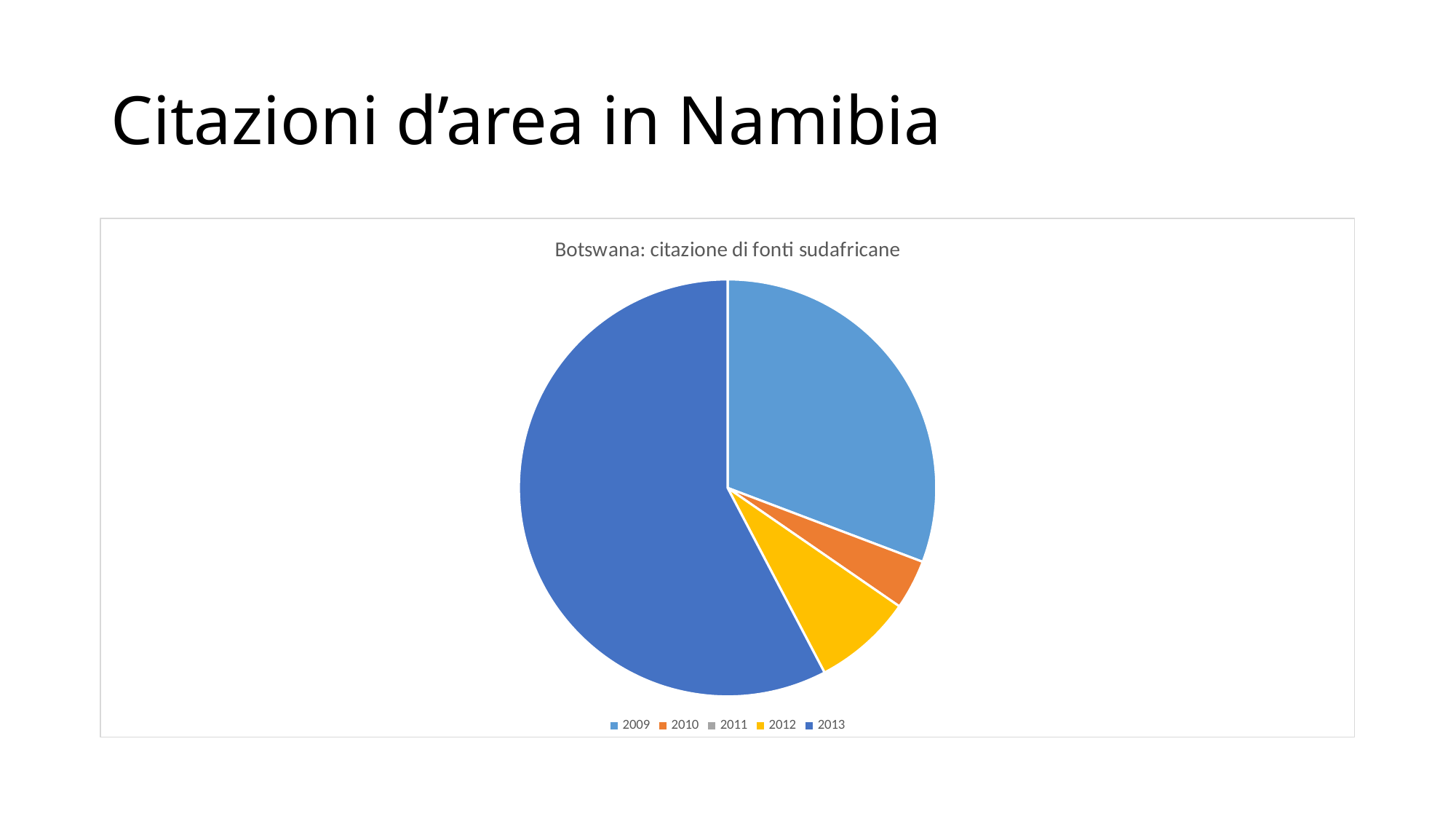
Which year has the largest slice of the pie? 2013 What is the title of the chart? Botswana: citazione di fonti sudafricane Which slice is larger, 2012 or 2010? 2012 What kind of chart is shown on the slide? pie chart Which slice is larger, 2013 or 2009? 2013 Which slice is larger, 2009 or 2012? 2009 How many entries does the chart legend list? 5 Which legend entry has no visible slice in the pie? 2011 Which year has the second-largest slice of the pie? 2009